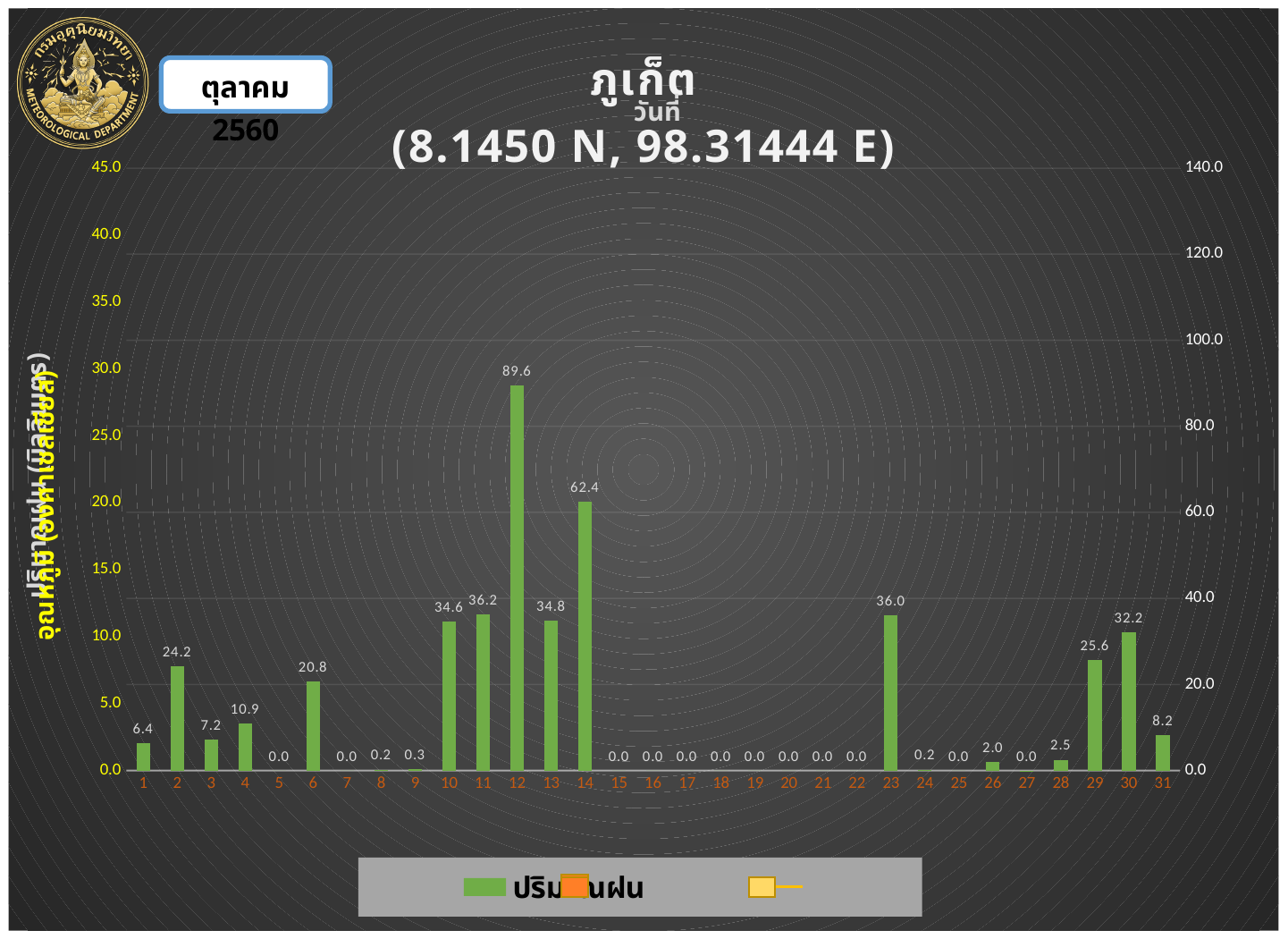
What is the difference between the values for day 2 and day 3? 17.0 What is the value shown for day 12? 89.6 Do the values rise or fall from day 10 to day 12? rise How many days are shown along the x axis? 31 What is the value shown for day 29? 25.6 What coordinates are given in the chart title? 8.1450 N, 98.31444 E What is the value shown for day 23? 36.0 What is the value shown for day 31? 8.2 Which day has the highest bar? 12 What is the difference between the values for day 12 and day 14? 27.2 What kind of chart is shown on the slide? bar chart Which is larger, the value for day 2 or the value for day 6? day 2